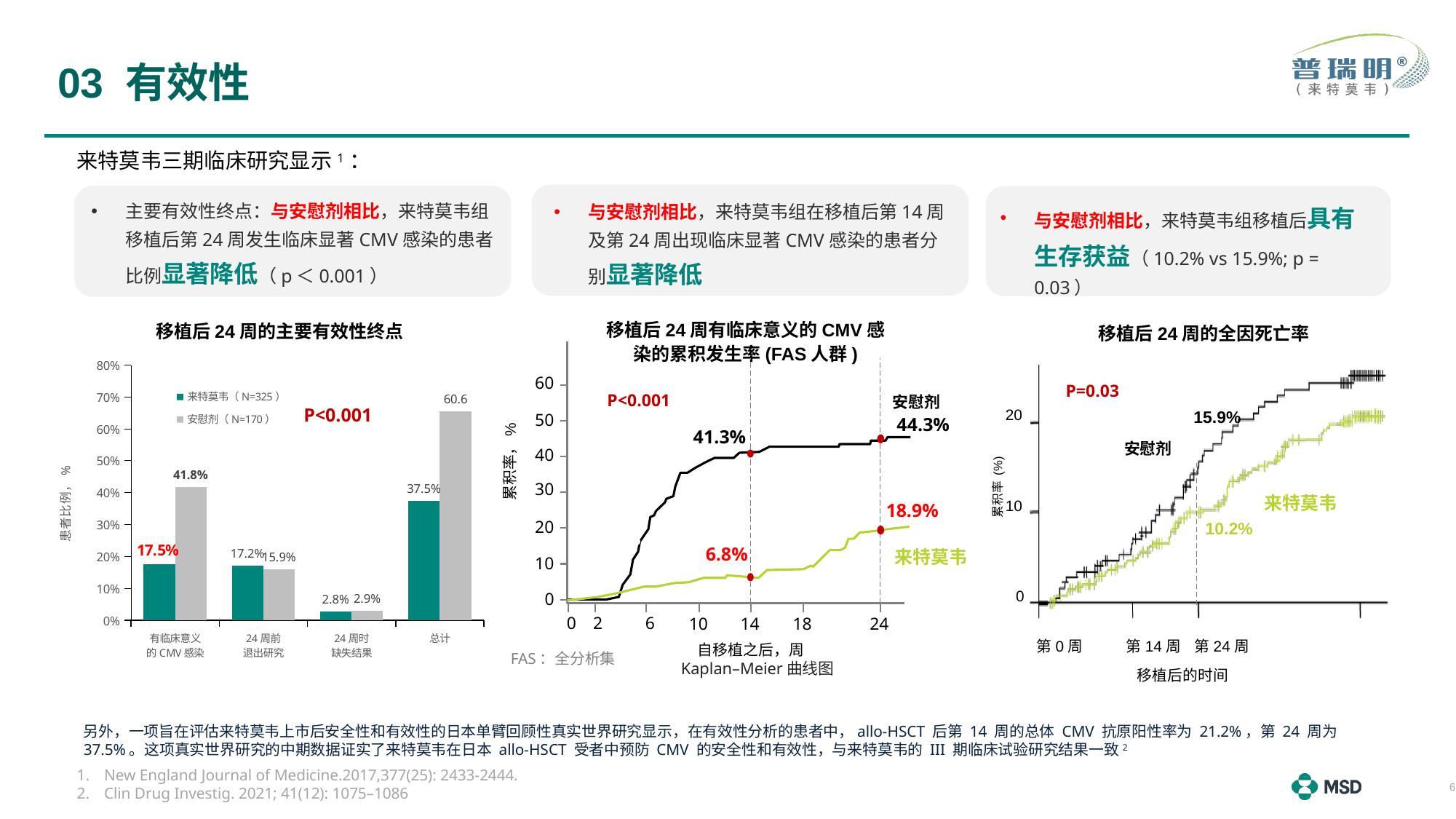
In the middle Kaplan–Meier chart, what is the cumulative incidence for 来特莫韦 at week 14? 6.8% In the chart titled 移植后 24 周的主要有效性终点, what is the difference between the 安慰剂 and 来特莫韦 values for 有临床意义的 CMV 感染? 24.3% In the chart titled 移植后 24 周的主要有效性终点, how many categories are shown on the x axis? 4 In the chart titled 移植后 24 周的全因死亡率, what is the value labelled for 来特莫韦? 10.2% In the chart titled 移植后 24 周的主要有效性终点, what is the value for 安慰剂 in the 总计 category? 60.6 In the chart titled 移植后 24 周的主要有效性终点, which is larger for 24 周前退出研究: 来特莫韦 or 安慰剂? 来特莫韦 In the middle Kaplan–Meier chart, what is the cumulative incidence for 安慰剂 at week 24? 44.3% In the chart titled 移植后 24 周的主要有效性终点, how many series does the legend list? 2 In the middle Kaplan–Meier chart, what is the difference between the 安慰剂 and 来特莫韦 values at week 24? 25.4% In the chart titled 移植后 24 周的主要有效性终点, what is the value for 来特莫韦 in the 有临床意义的 CMV 感染 category? 17.5% In the chart titled 移植后 24 周的主要有效性终点, which category has the lowest value for 来特莫韦? 24 周时缺失结果 What kind of chart is the one titled 移植后 24 周的主要有效性终点? bar chart